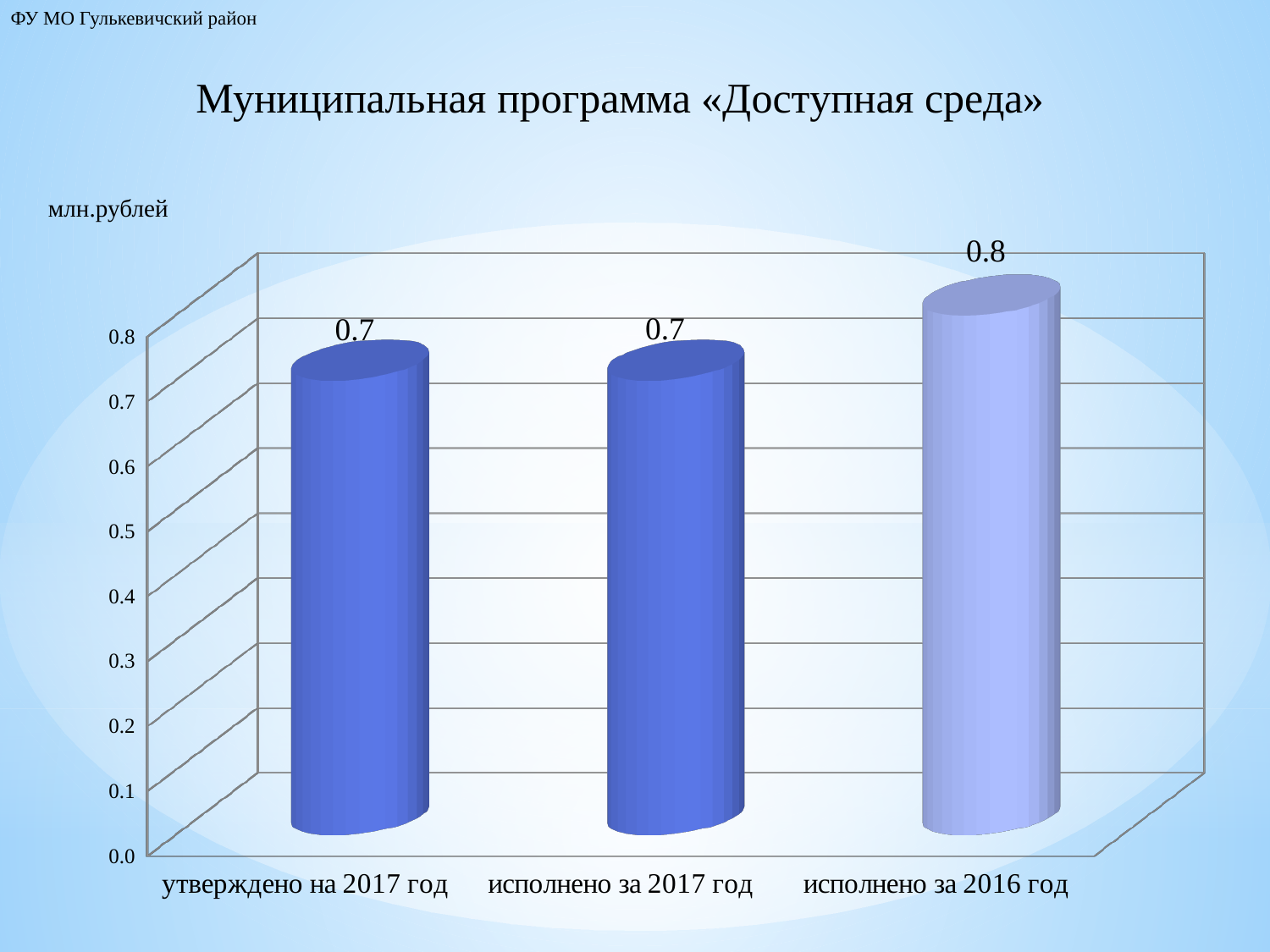
What is the value for «исполнено за 2017 год»? 0.7 Which category has the highest value? исполнено за 2016 год What is the difference between the value for «исполнено за 2016 год» and the value for «исполнено за 2017 год»? 0.1 What unit is indicated for the values on the chart? млн.рублей What is the title of the chart? Муниципальная программа «Доступная среда» How many categories are shown on the chart? 3 Is the value for «утверждено на 2017 год» greater or less than 0.4? greater What is the value for «исполнено за 2016 год»? 0.8 Is the value for «исполнено за 2016 год» greater or less than 0.5? greater Which is larger: the value for «исполнено за 2016 год» or the value for «утверждено на 2017 год»? исполнено за 2016 год What is the value for «утверждено на 2017 год»? 0.7 What kind of chart is shown on the slide? bar chart